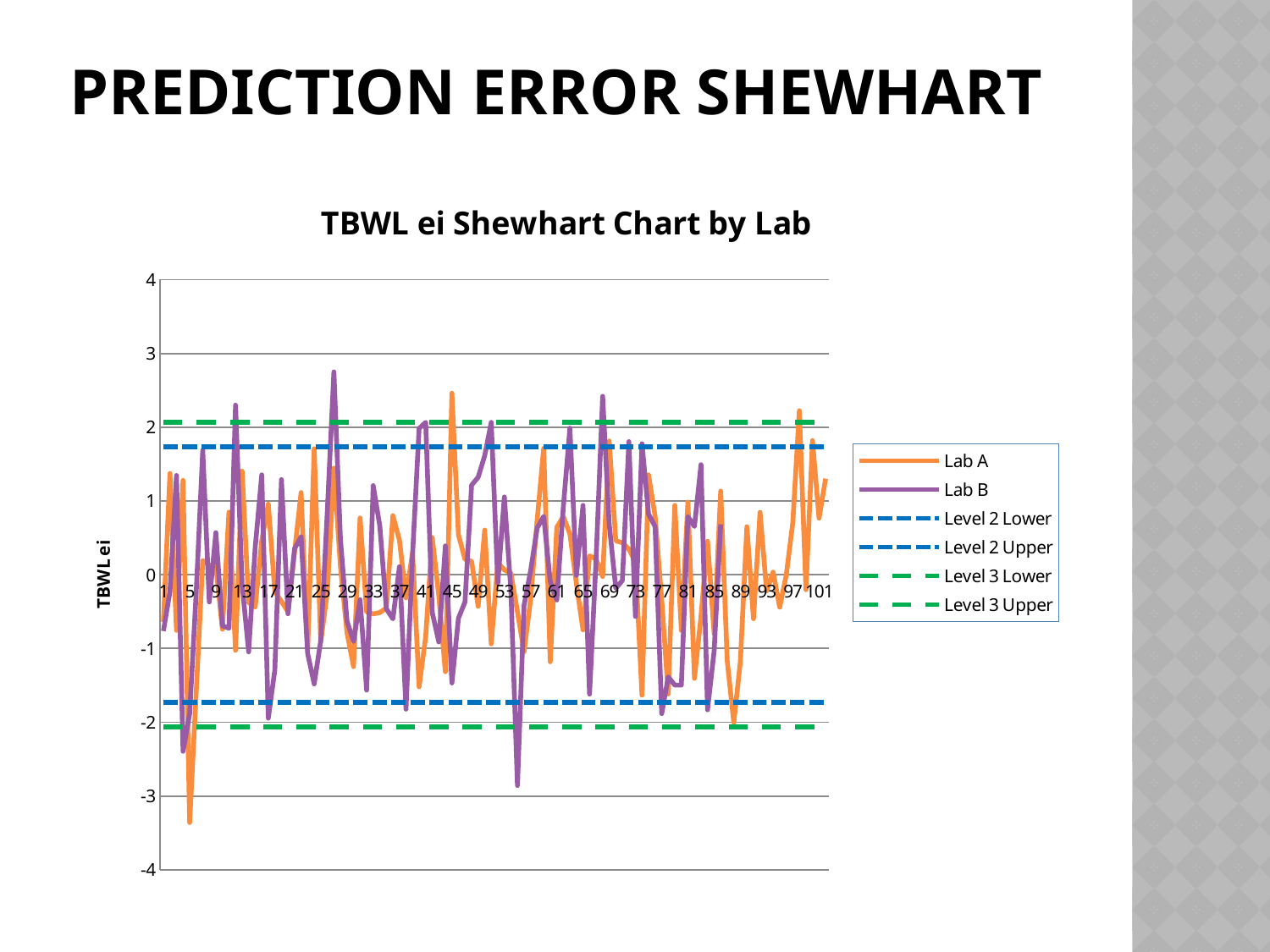
What is the label on the vertical axis? TBWL ei Is the Level 2 Lower line greater or less than -2? greater Is the lowest value of Lab A greater or less than -3? less What kind of chart is shown on the slide? line chart Is the Level 3 Lower line greater or less than -2? less What is the title of the chart? TBWL ei Shewhart Chart by Lab Which series reaches the lowest value on the chart, Lab A or Lab B? Lab A What is the highest value shown on the vertical axis? 4 Which line is higher on the chart, Level 3 Upper or Level 2 Upper? Level 3 Upper How many series does the legend list? 6